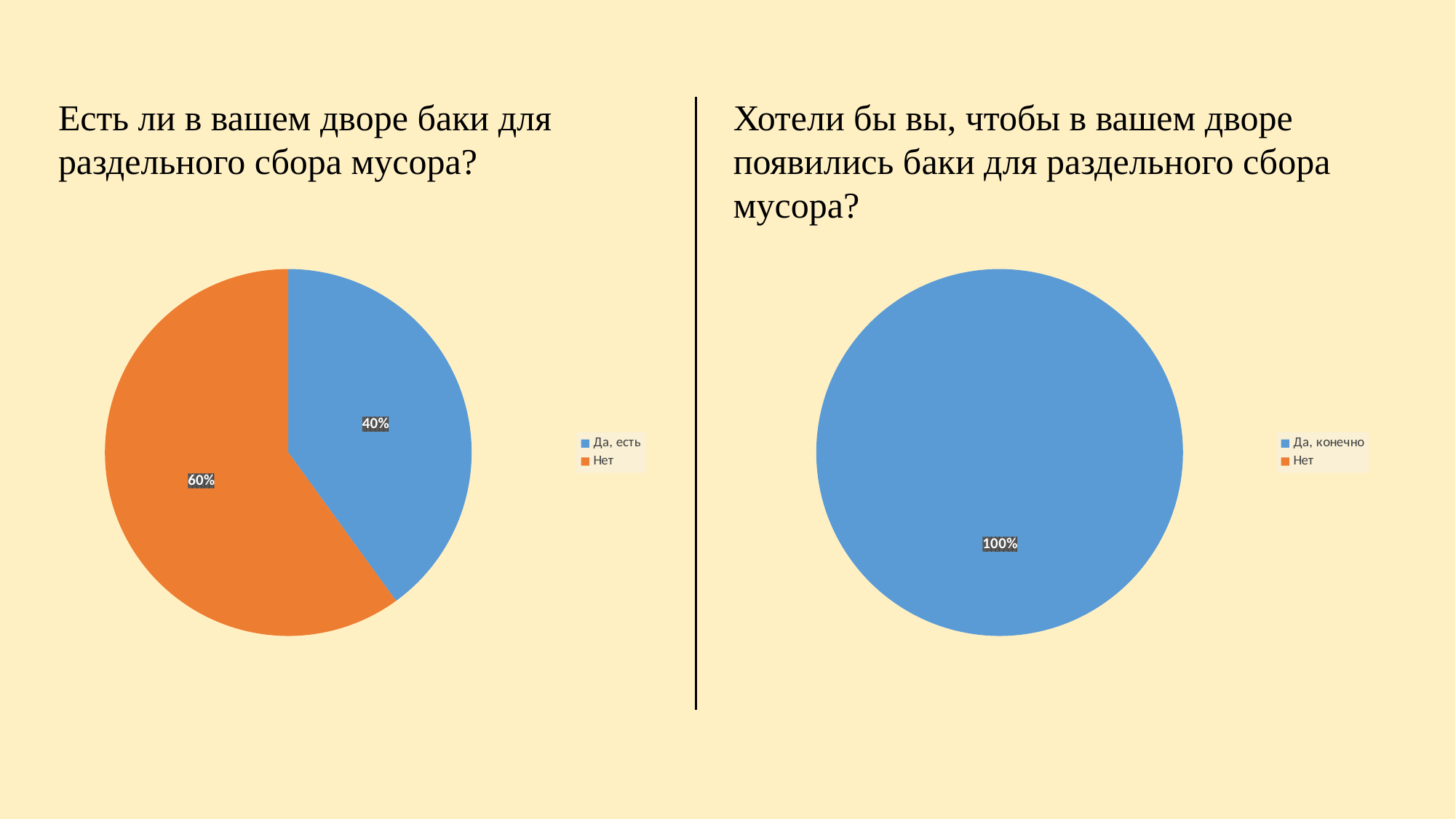
In the right chart ("Хотели бы вы, чтобы в вашем дворе появились баки для раздельного сбора мусора?"), what share of the pie is "Да, конечно"? 100% In the left chart ("Есть ли в вашем дворе баки для раздельного сбора мусора?"), what colour is the "Нет" slice? Orange In the left chart ("Есть ли в вашем дворе баки для раздельного сбора мусора?"), how many categories does the legend list? 2 In the left chart ("Есть ли в вашем дворе баки для раздельного сбора мусора?"), what is the difference in percentage points between "Нет" and "Да, есть"? 20% In the left chart ("Есть ли в вашем дворе баки для раздельного сбора мусора?"), which is larger: "Да, есть" or "Нет"? Нет What kind of chart is shown on the left side of the slide? Pie chart In the left chart ("Есть ли в вашем дворе баки для раздельного сбора мусора?"), what share of the pie is "Нет"? 60% What kind of chart is shown on the right side of the slide? Pie chart In the left chart ("Есть ли в вашем дворе баки для раздельного сбора мусора?"), which category has the largest slice? Нет In the right chart ("Хотели бы вы, чтобы в вашем дворе появились баки для раздельного сбора мусора?"), how many categories does the legend list? 2 In the left chart ("Есть ли в вашем дворе баки для раздельного сбора мусора?"), what share of the pie is "Да, есть"? 40% In the left chart ("Есть ли в вашем дворе баки для раздельного сбора мусора?"), which category has the smallest slice? Да, есть